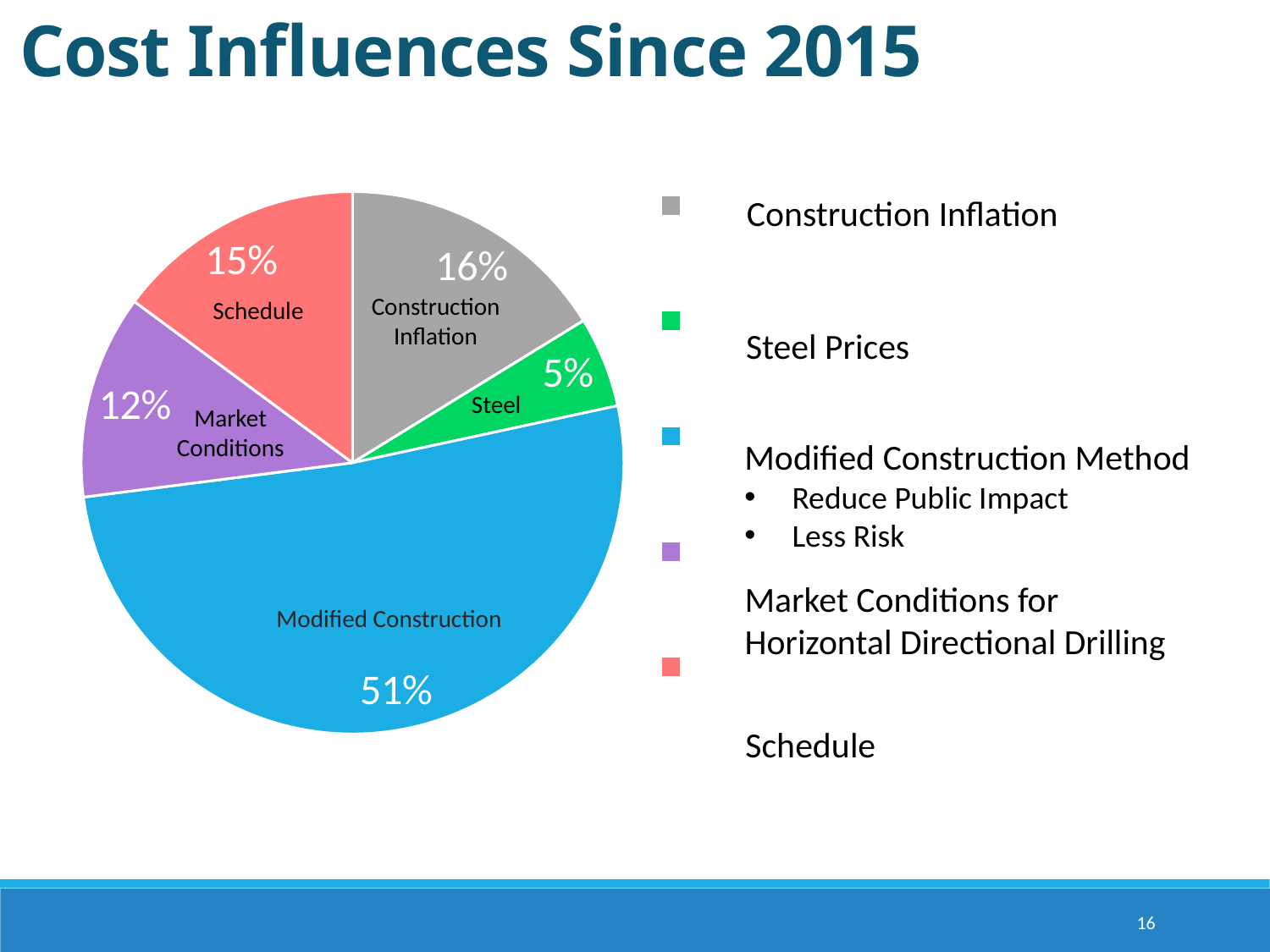
What colour is the Steel slice of the pie? Green What percentage of the pie is Modified Construction? 51% Which slice of the pie is the largest? Modified Construction How many slices does the pie chart have? 5 What percentage of the pie is Steel? 5% Which is larger, the Schedule slice or the Market Conditions slice? Schedule Which slice of the pie is the smallest? Steel What is the difference in percentage points between Modified Construction and Construction Inflation? 35 What percentage of the pie is Construction Inflation? 16% What type of chart is shown on the slide? Pie chart What percentage of the pie is Schedule? 15% What percentage of the pie is Market Conditions? 12%